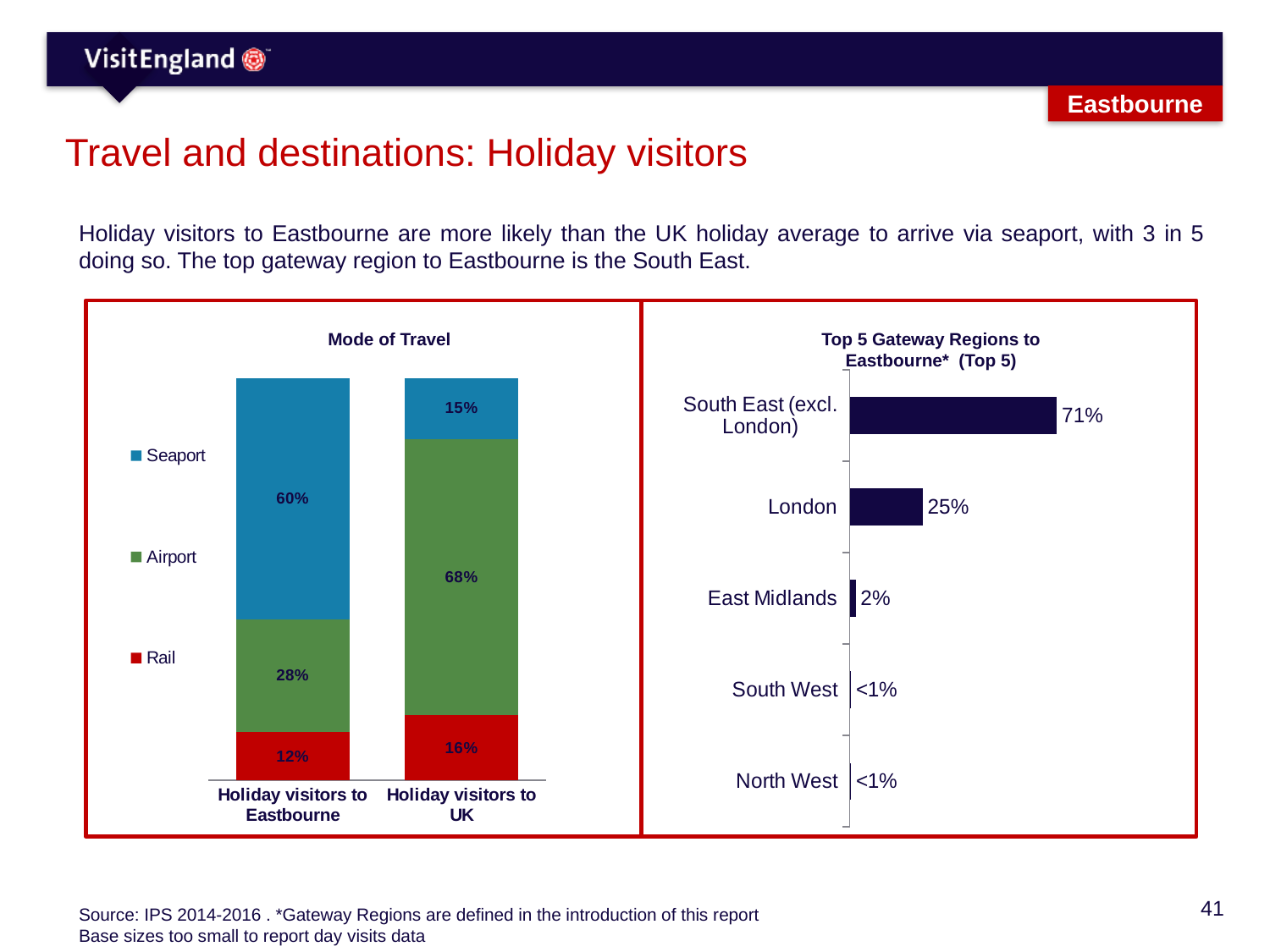
In the Top 5 Gateway Regions to Eastbourne chart, what is the value for London? 25% What kind of chart is the Mode of Travel chart? Stacked bar chart In the Mode of Travel chart, which is larger: the airport share for holiday visitors to Eastbourne or for holiday visitors to the UK? Holiday visitors to UK How many regions are shown in the Top 5 Gateway Regions to Eastbourne chart? 5 In the Mode of Travel chart, what percentage of holiday visitors to Eastbourne arrive by rail? 12% In the Mode of Travel chart, what percentage of holiday visitors to the UK arrive by airport? 68% In the Top 5 Gateway Regions to Eastbourne chart, what is the value for East Midlands? 2% How many series does the legend of the Mode of Travel chart list? 3 In the Mode of Travel chart, what percentage of holiday visitors to Eastbourne arrive by seaport? 60% In the Mode of Travel chart, what is the difference between the seaport share for holiday visitors to Eastbourne and for holiday visitors to the UK? 45% In the Top 5 Gateway Regions to Eastbourne chart, what is the difference between the values for South East (excl. London) and London? 46% In the Top 5 Gateway Regions to Eastbourne chart, which region has the highest value? South East (excl. London)